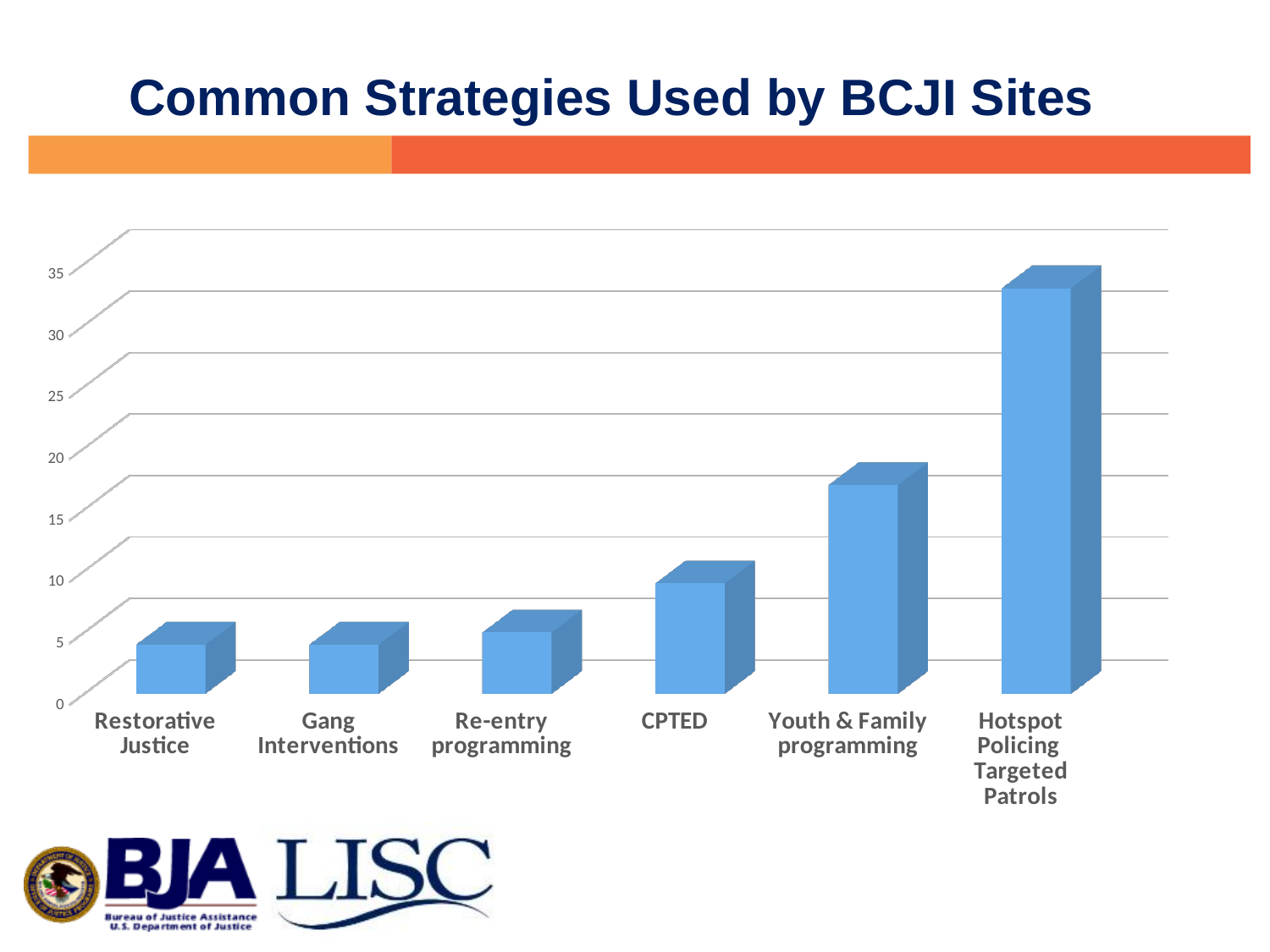
What is the title of the slide containing the chart? Common Strategies Used by BCJI Sites Is the value for Hotspot Policing Targeted Patrols greater or less than 30? greater Is the value for Youth & Family programming greater or less than 20? less Is the value for Youth & Family programming greater or less than 15? greater Which strategy has the highest bar? Hotspot Policing Targeted Patrols What kind of chart is shown on the slide? bar chart Do the bar values generally rise or fall from left to right along the x axis? rise Which is larger, the value for CPTED or the value for Youth & Family programming? Youth & Family programming How many strategy categories are shown on the x axis? 6